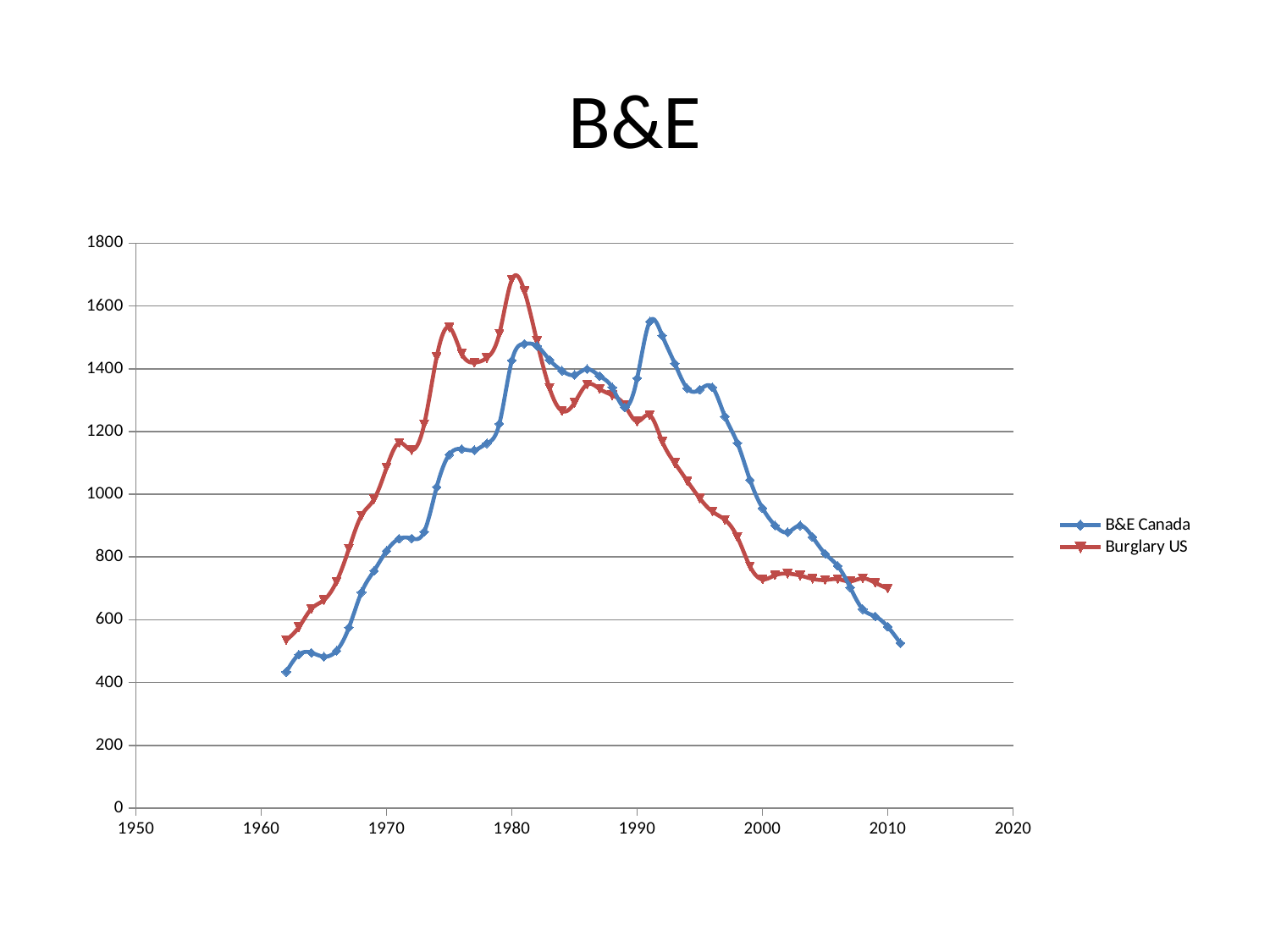
Is the value for B&E Canada in 1991 greater or less than 1400? greater What kind of chart is shown on the slide? Line chart Is the value for Burglary US in 2010 greater or less than 800? less In 2000, which series has the higher value, B&E Canada or Burglary US? B&E Canada Is the value for B&E Canada in 1962 greater or less than 600? less In 1975, which series has the higher value, B&E Canada or Burglary US? Burglary US How many series does the legend list? 2 What is the title of the chart? B&E Which series is drawn in red? Burglary US Which series reaches the highest value on the chart? Burglary US Does the Burglary US series rise or fall between 1980 and 2000? Fall